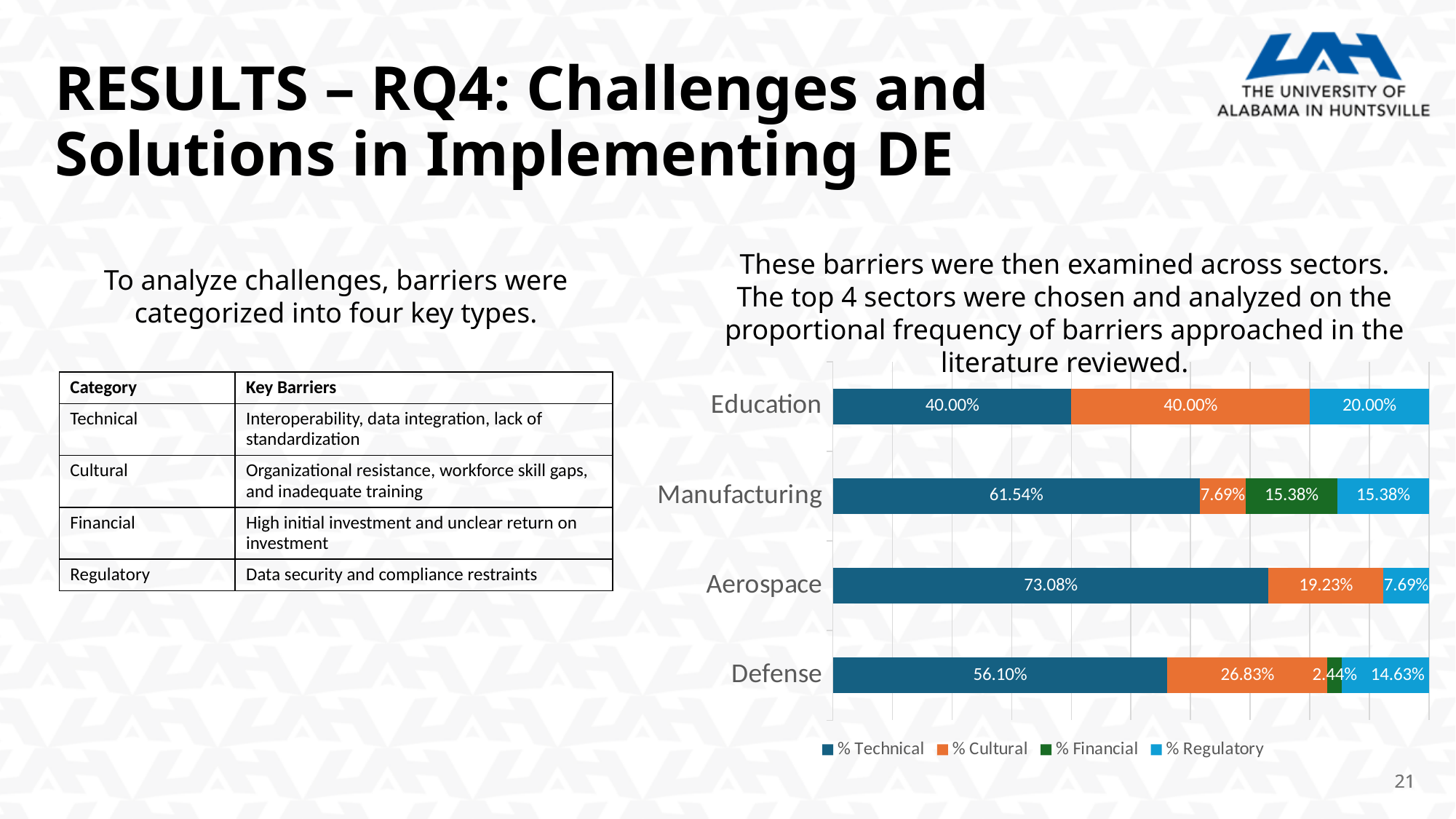
How many sectors are plotted in the chart? 4 What is the % Technical value for Aerospace? 73.08% What is the % Financial value for Manufacturing? 15.38% What is the % Cultural value for Defense? 26.83% Which sector has the lowest % Technical value? Education Which is larger, the % Cultural value for Education or the % Cultural value for Aerospace? Education What is the % Regulatory value for Education? 20.00% What type of chart is shown on the slide? Stacked bar chart Which sector has the highest % Technical value? Aerospace Which series is shown in orange in the chart legend? % Cultural What is the difference between the % Technical values for Aerospace and Defense? 16.98% How many series does the chart legend list? 4